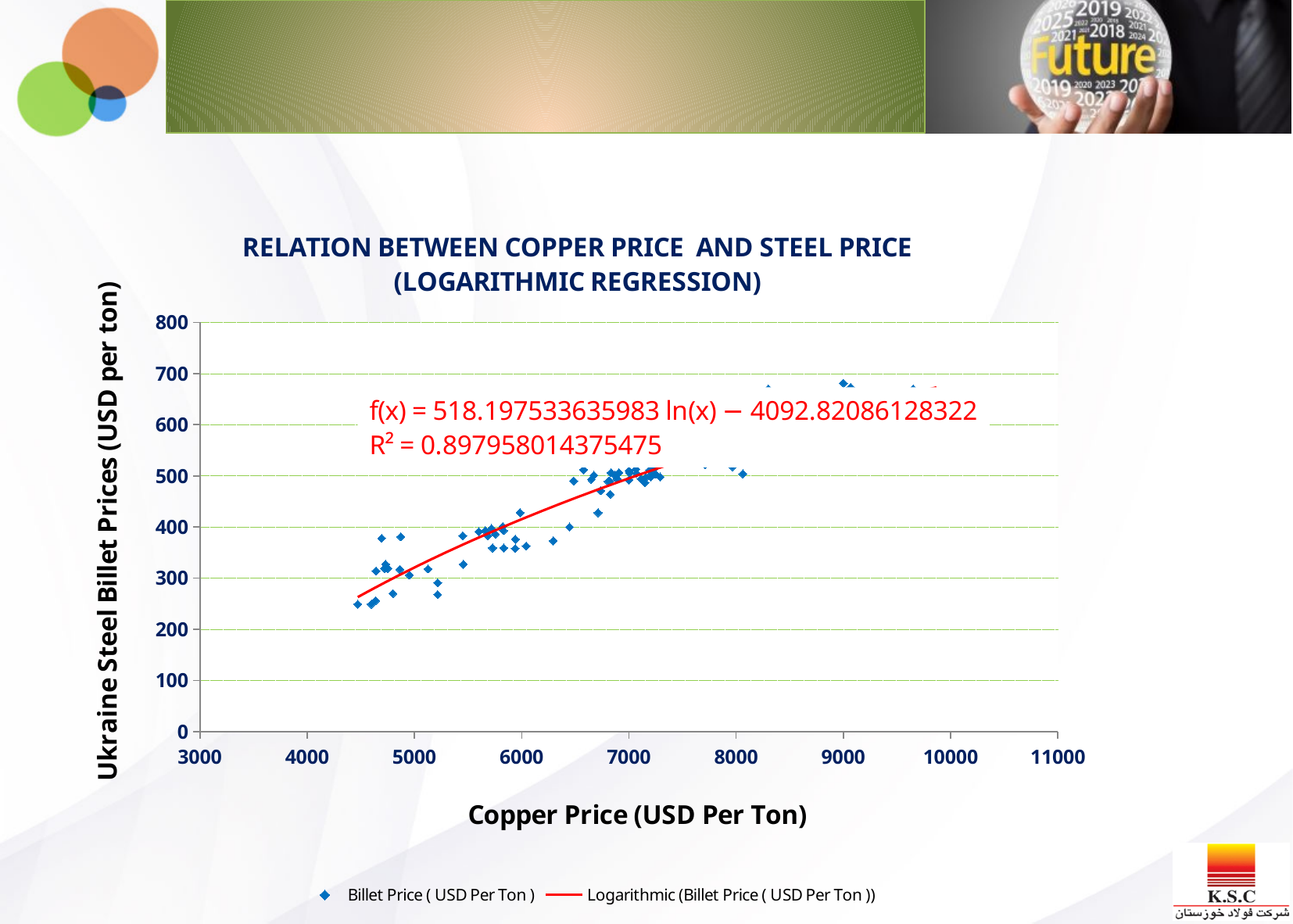
Is the billet price for the points near a copper price of 9000 greater or less than 600? greater Is the billet price for the lowest-copper-price point (near 4500) greater or less than 300? less What kind of chart is shown on the slide? Scatter chart Which has the higher billet price: the points near a copper price of 9000 or the points near a copper price of 5000? Points near 9000 Do the billet prices generally rise or fall as the copper price increases along the x axis? Rise How many entries does the chart legend list? 2 Is the billet price for the points near a copper price of 8000 greater or less than 400? greater What is the maximum value shown on the y axis? 800 What is the R² value shown for the logarithmic regression? 0.897958014375475 What is the regression equation shown on the chart? f(x) = 518.197533635983 ln(x) − 4092.82086128322 What is the title of the chart? RELATION BETWEEN COPPER PRICE AND STEEL PRICE (LOGARITHMIC REGRESSION) What is the label of the x axis? Copper Price (USD Per Ton)